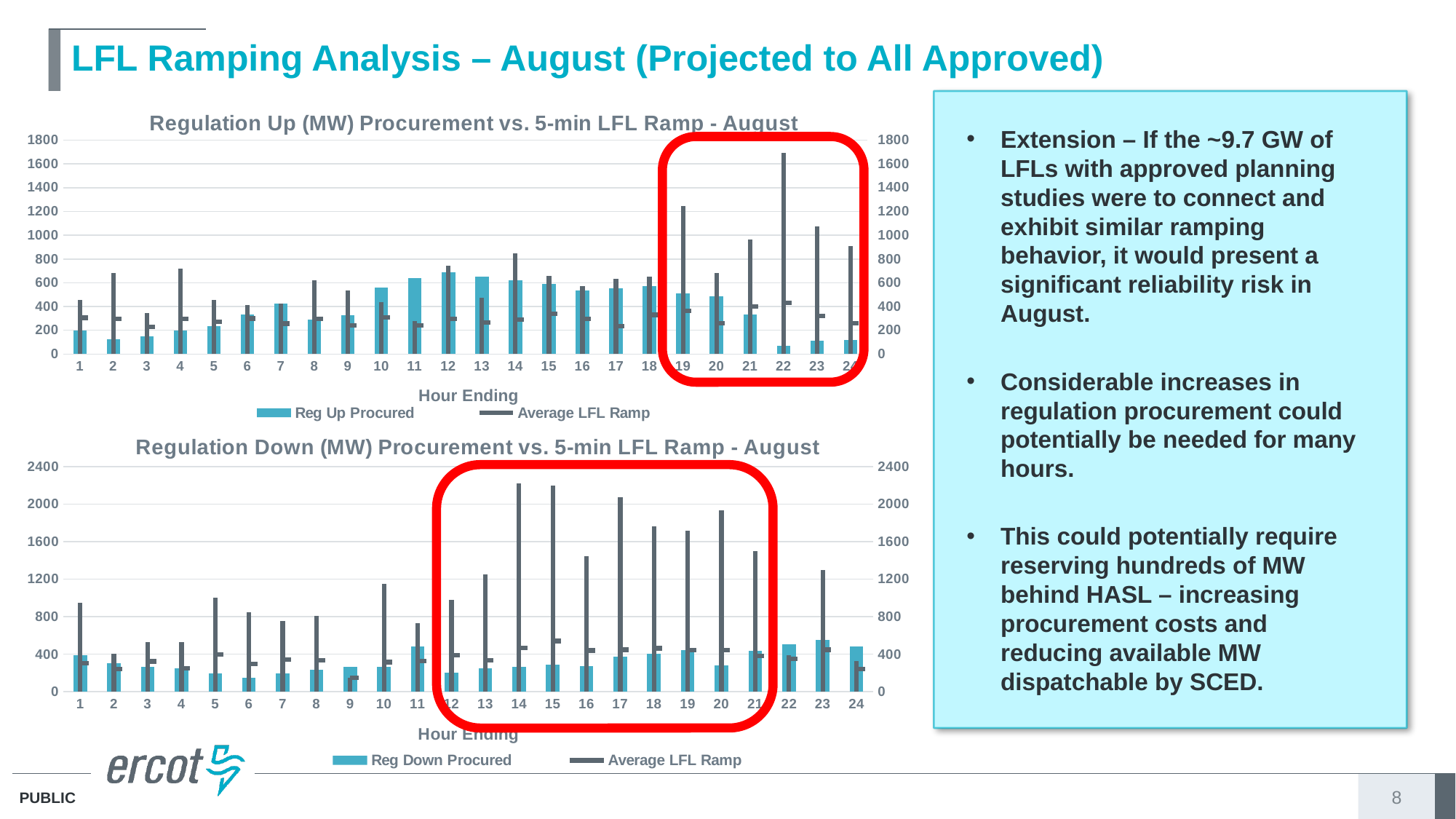
In the bottom chart (Regulation Down), which is larger, Reg Down Procured at hour ending 1 or at hour ending 6? Hour ending 1 In the top chart (Regulation Up), which is larger, the Average LFL Ramp at hour ending 22 or at hour ending 19? Hour ending 22 In the top chart (Regulation Up), at which hour ending is Reg Up Procured lowest? 22 In the bottom chart (Regulation Down), is the Average LFL Ramp at hour ending 14 greater or less than 2000? less In the top chart (Regulation Up), how many series does the legend list? 2 In the top chart (Regulation Up), how many hours are shown on the x axis? 24 In the top chart (Regulation Up), at which hour ending is the Average LFL Ramp highest? 22 What kind of chart is the bottom chart (Regulation Down)? Bar chart In the bottom chart (Regulation Down), is the Average LFL Ramp at hour ending 9 greater or less than 400? less In the top chart (Regulation Up), is Reg Up Procured at hour ending 1 greater or less than 400? less What is the x-axis title of the bottom chart (Regulation Down)? Hour Ending